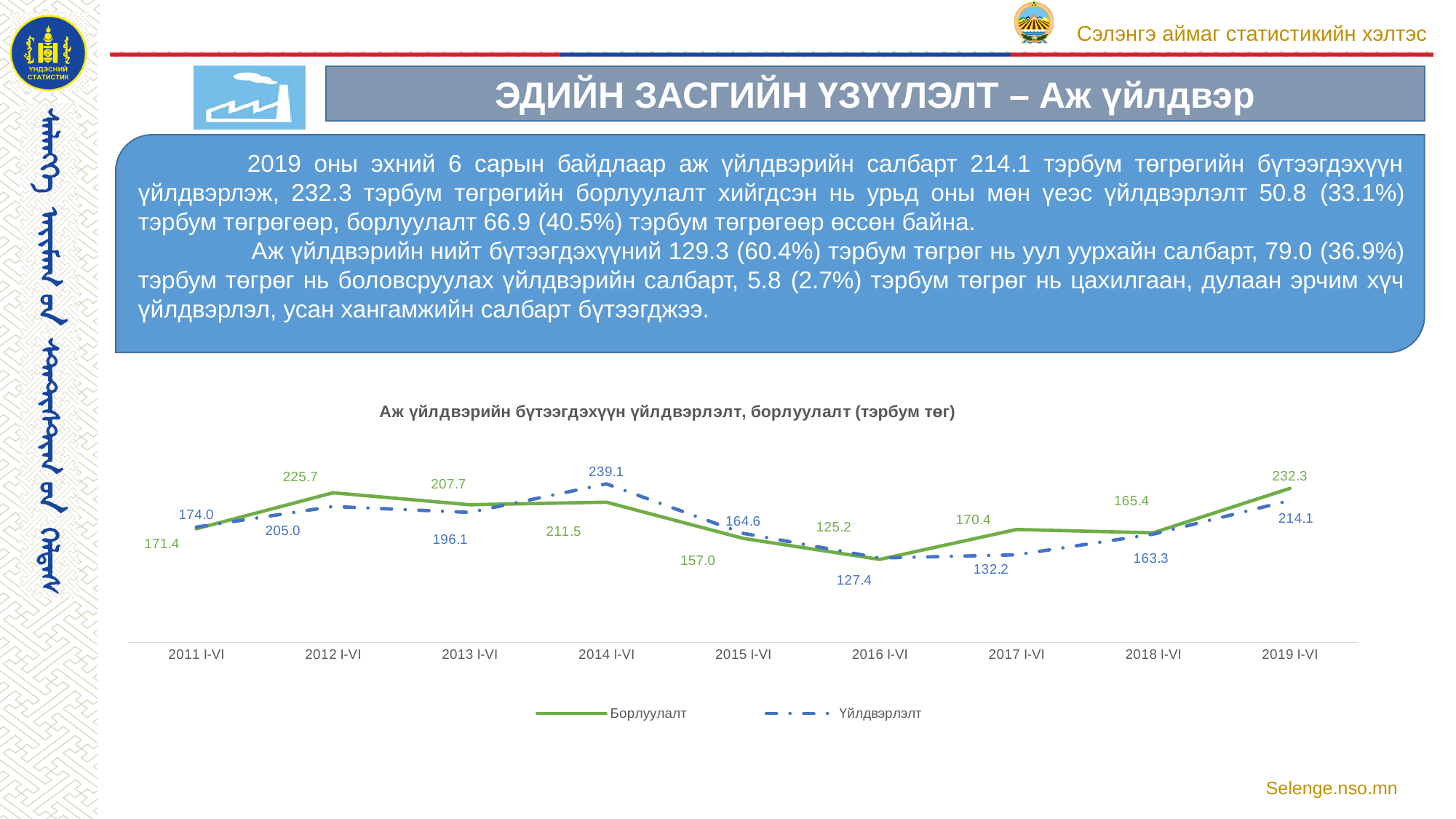
What is the value of Үйлдвэрлэлт for 2017 I-VI? 132.2 What is the title of the chart? Аж үйлдвэрийн бүтээгдэхүүн үйлдвэрлэлт, борлуулалт (тэрбум төг) In which period is Борлуулалт lowest? 2016 I-VI Which is larger in 2014 I-VI, Борлуулалт or Үйлдвэрлэлт? Үйлдвэрлэлт What is the value of Борлуулалт for 2019 I-VI? 232.3 What type of chart is shown on the slide? Line chart What is the value of Үйлдвэрлэлт for 2014 I-VI? 239.1 How many series does the chart legend list? 2 What is the difference between Борлуулалт and Үйлдвэрлэлт in 2019 I-VI? 18.2 How many periods are plotted along the x axis of the chart? 9 In which period is Үйлдвэрлэлт highest? 2014 I-VI Does Борлуулалт rise or fall from 2018 I-VI to 2019 I-VI? Rise